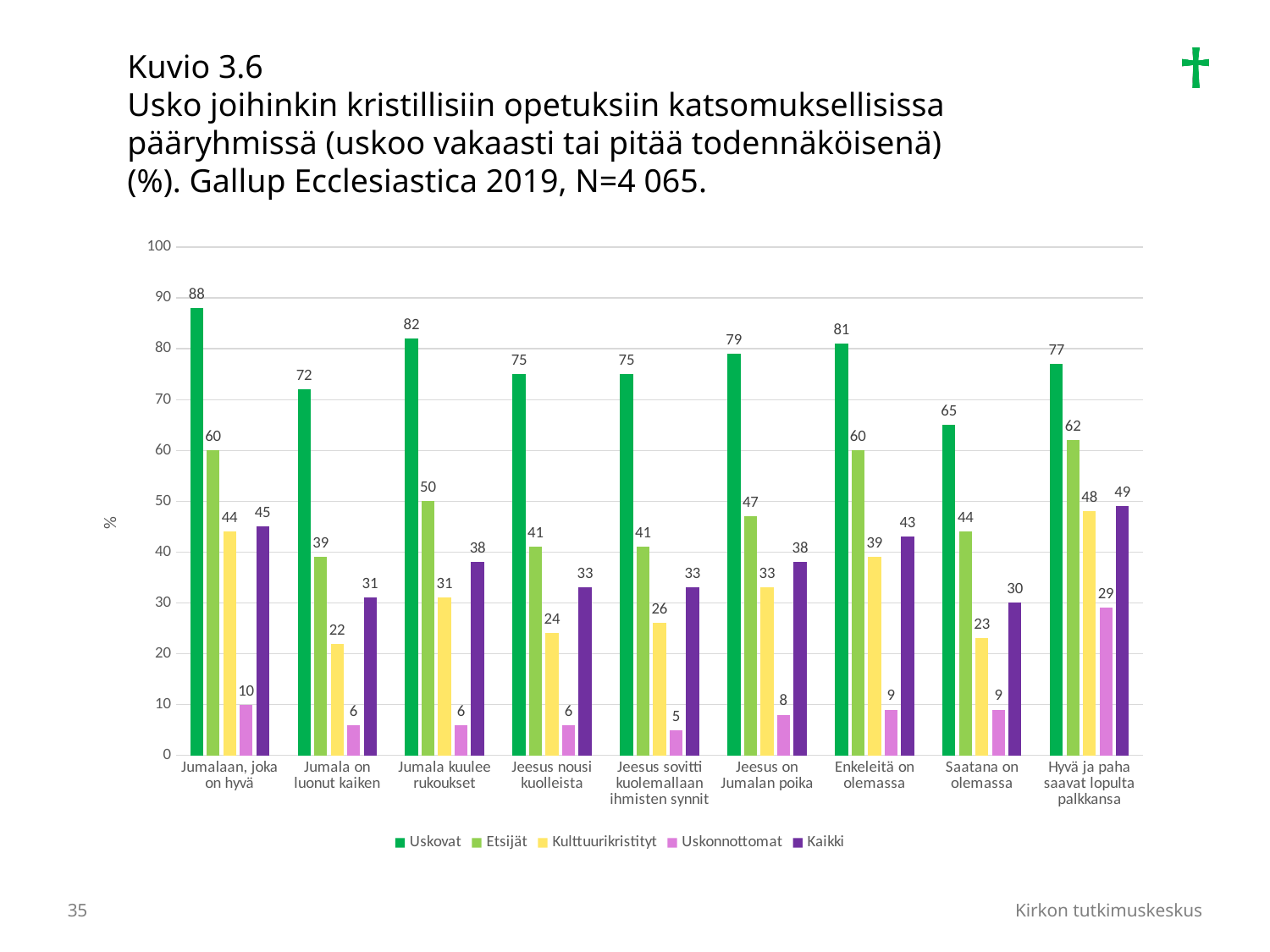
How many categories are shown on the x axis? 9 Which category has the highest value for the Kaikki series? Hyvä ja paha saavat lopulta palkkansa What is the value for Uskovat in the category "Jumalaan, joka on hyvä"? 88 What is the difference between the Uskovat and Etsijät values in the category "Jumala on luonut kaiken"? 33 What is the value for Kaikki in the category "Enkeleitä on olemassa"? 43 How many series does the legend list? 5 What kind of chart is shown on the slide? Bar chart What is the value for Uskonnottomat in the category "Hyvä ja paha saavat lopulta palkkansa"? 29 Which is larger: the Kulttuurikristityt value for "Jumala kuulee rukoukset" or for "Jeesus on Jumalan poika"? Jeesus on Jumalan poika What is the value for Etsijät in the category "Saatana on olemassa"? 44 Which series is shown in yellow in the legend? Kulttuurikristityt Which category has the lowest value for the Uskovat series? Saatana on olemassa